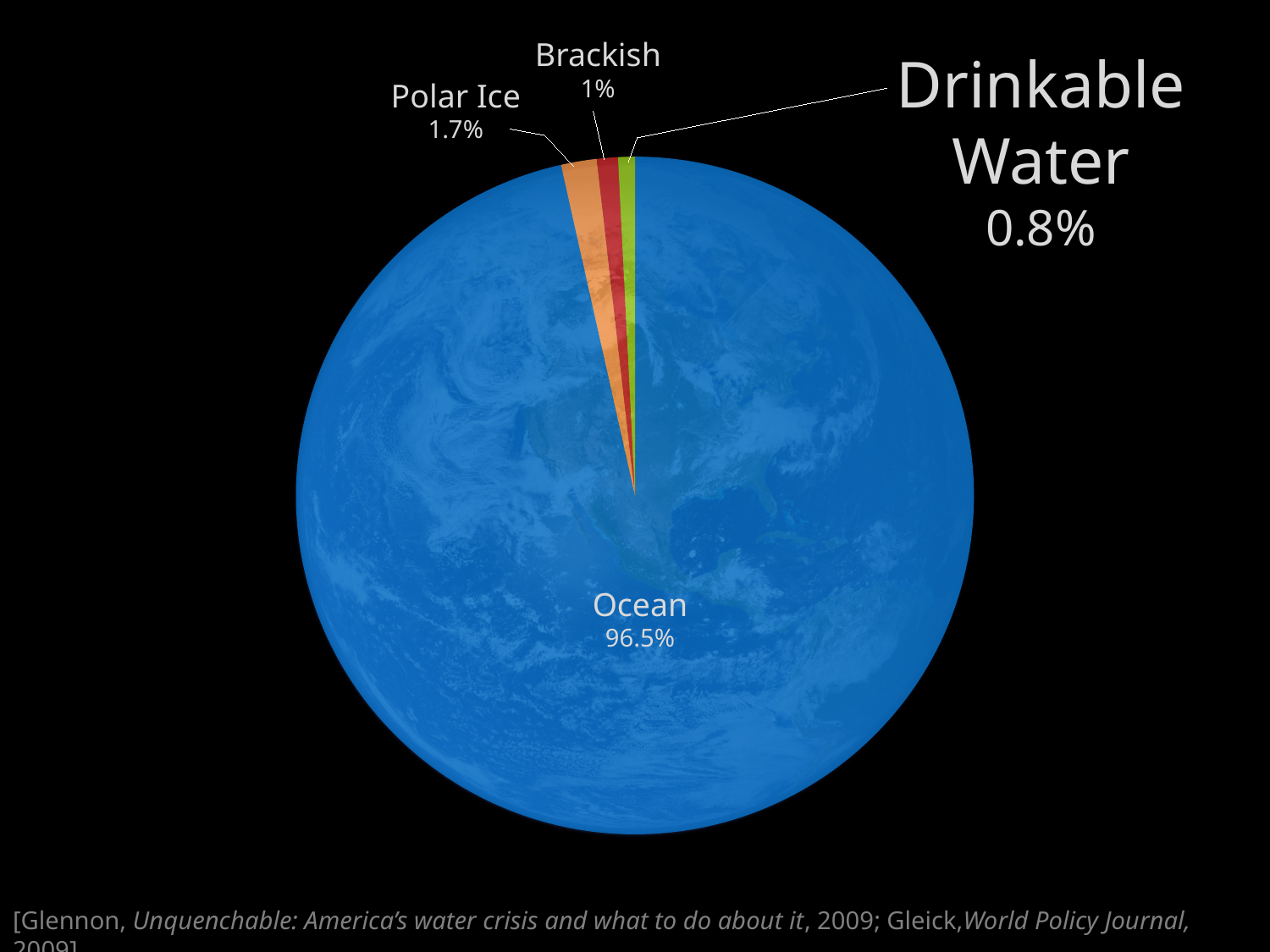
Which slice of the pie is the largest? Ocean What percentage of the pie is labelled Ocean? 96.5% What is the difference between the Polar Ice percentage and the Drinkable Water percentage? 0.9% How many slices does the pie chart have? 4 What kind of chart is shown on the slide? pie chart What percentage is shown for Drinkable Water? 0.8% Which slice of the pie is the smallest? Drinkable Water What colour is the Ocean slice of the pie? blue What percentage is shown for Brackish? 1% What is the difference between the Ocean percentage and the Polar Ice percentage? 94.8% What percentage is shown for Polar Ice? 1.7% Which is larger, the Polar Ice slice or the Brackish slice? Polar Ice